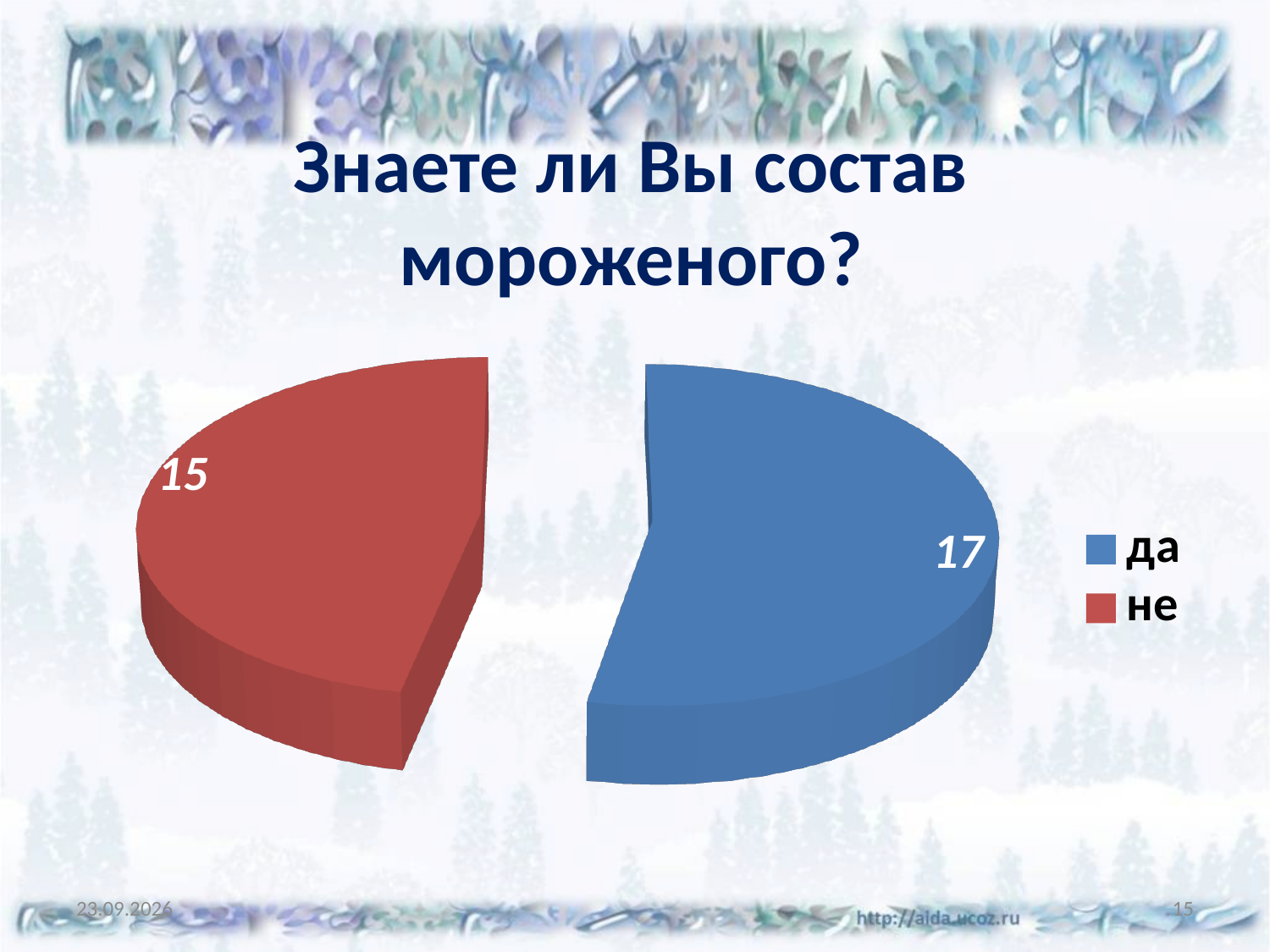
Which slice of the pie chart has the smallest value? не What value is shown for the "да" slice of the pie chart? 17 Which is larger in the pie chart, "да" or "не"? да How many entries does the legend of the pie chart list? 2 Which slice of the pie chart has the largest value? да What colour is the "не" slice in the pie chart? red What is the title of the slide above the pie chart? Знаете ли Вы состав мороженого? What is the difference between the "да" and "не" values in the pie chart? 2 How many slices does the pie chart have? 2 What value is shown for the "не" slice of the pie chart? 15 What kind of chart is shown on the slide? pie chart What is the total of the two values shown in the pie chart? 32